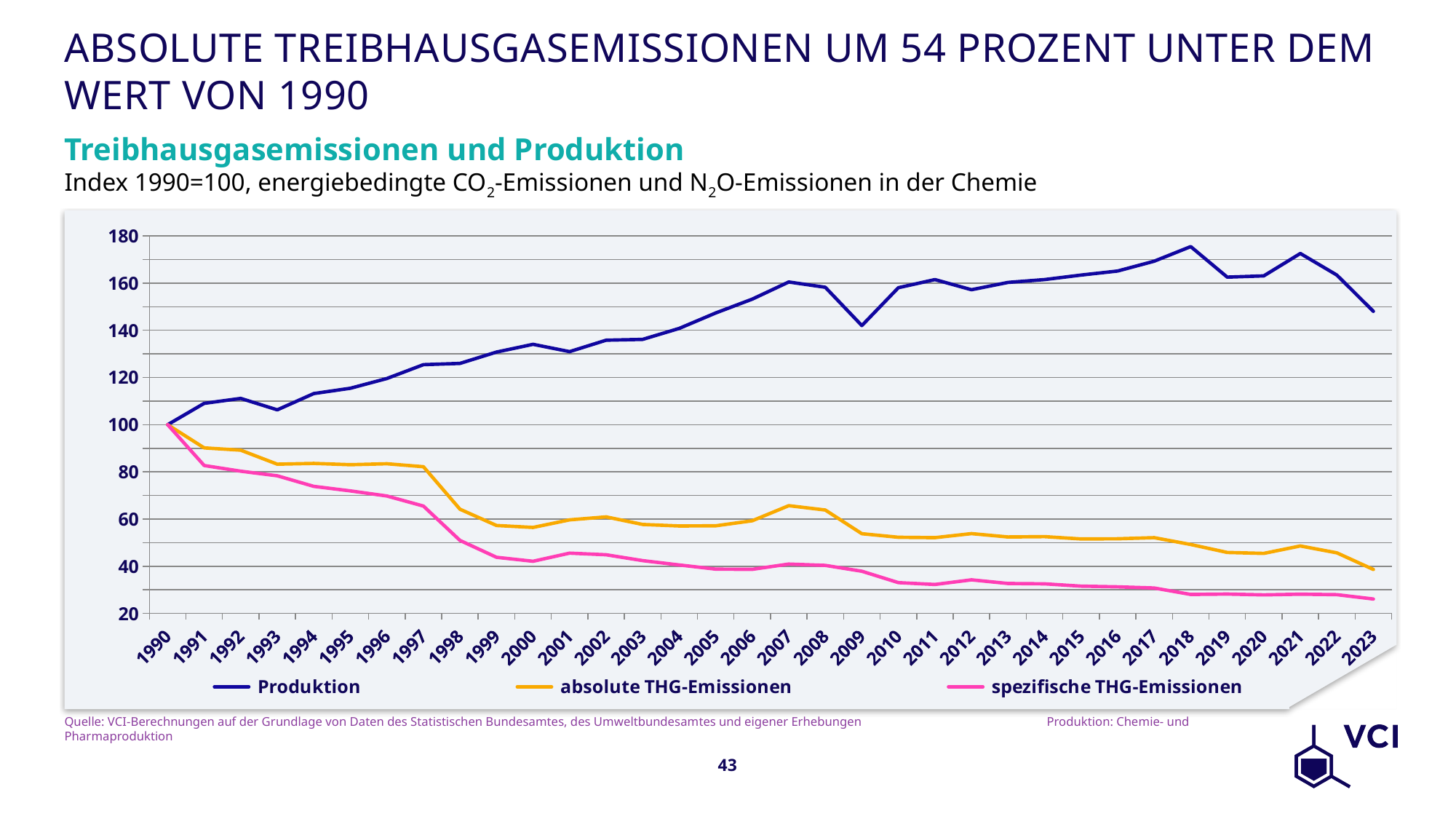
Which series is drawn in orange? absolute THG-Emissionen Is the value for Produktion in 2018 greater or less than 160? greater Is the value for spezifische THG-Emissionen in 2023 greater or less than 40? less How many series does the legend list? 3 Is the value for absolute THG-Emissionen in 2007 greater or less than 60? greater In which year is the spezifische THG-Emissionen line at its lowest? 2023 Does the spezifische THG-Emissionen line generally rise or fall from 1990 to 2023? fall In which year does the Produktion line reach its highest value? 2018 How many years are plotted along the x axis? 34 What is the index value of Produktion in 1990? 100 What kind of chart is shown on the slide? line chart In 2023, which is larger: Produktion or absolute THG-Emissionen? Produktion